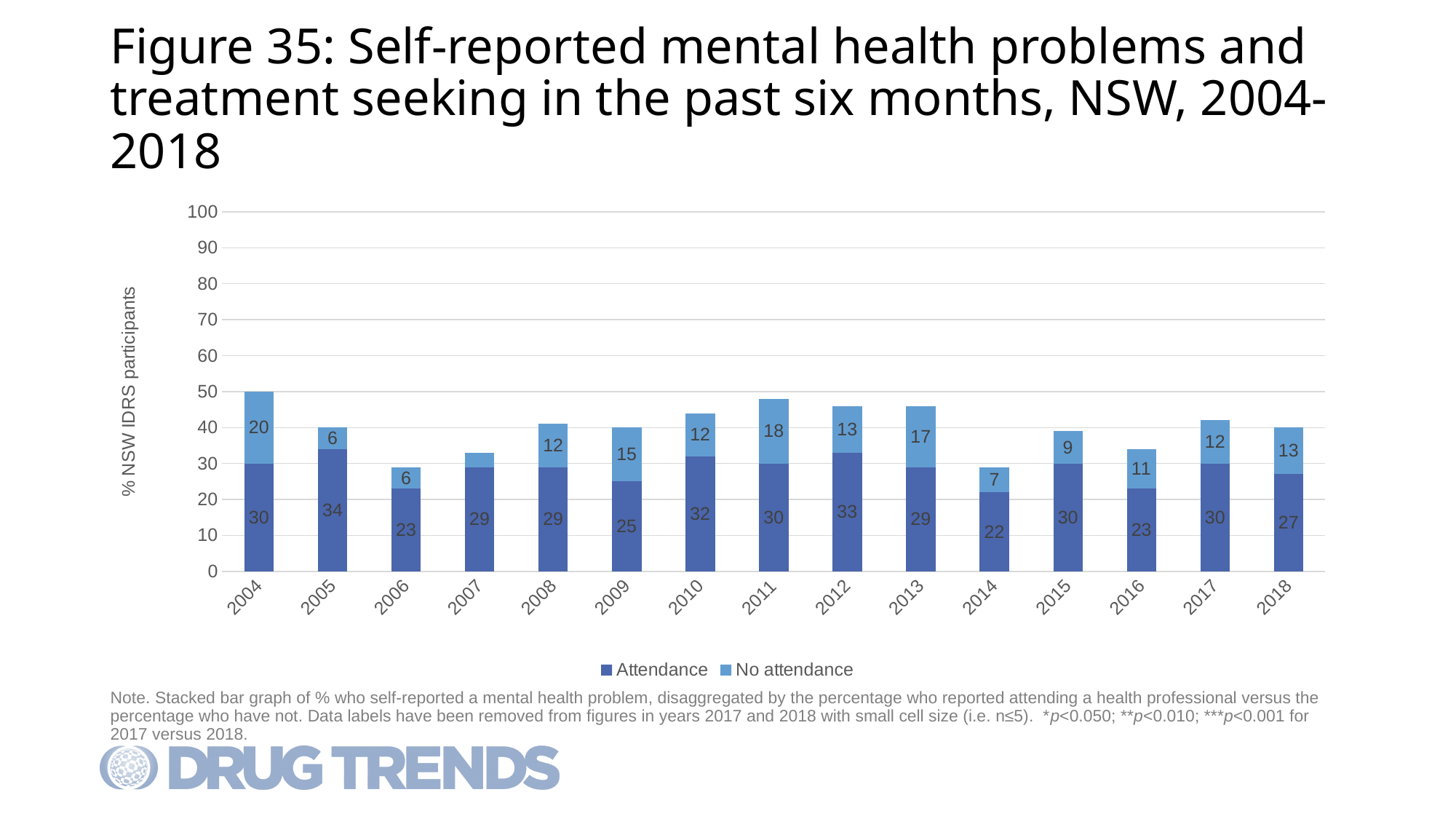
Which year has the highest No attendance value? 2004 What is the Attendance value for 2010? 32 Which is larger, the No attendance value for 2013 or for 2015? 2013 What is the difference between the Attendance values for 2005 and 2014? 12 Is the total height of the stacked bar for 2007 greater or less than 40? less Which year has the lowest Attendance value? 2014 What is the total of the stacked bar for 2004? 50 What is the No attendance value for 2011? 18 Which year has the highest Attendance value? 2005 What kind of chart is shown on the slide? Stacked bar chart How many series does the legend list? 2 How many years are shown on the x axis? 15